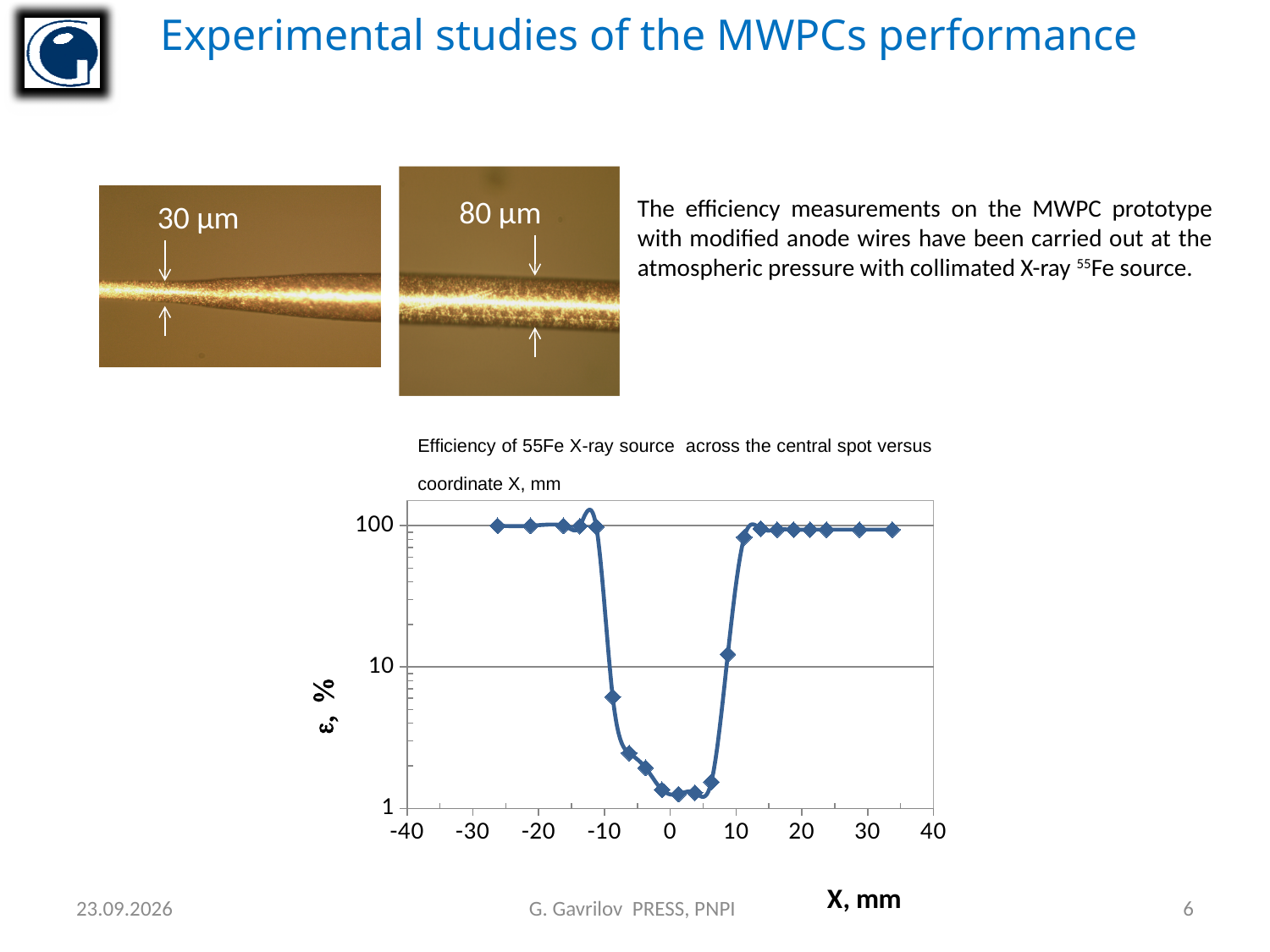
Is the efficiency at X = 0 mm greater or less than 10%? less Between X = -10 mm and X = 0 mm, do the efficiency values rise or fall? fall Which is larger, the efficiency at X = -20 mm or the efficiency at X = 0 mm? X = -20 mm Between X = 0 mm and X = 10 mm, do the efficiency values rise or fall? rise Is the efficiency at X = 30 mm greater or less than 10%? greater What is the label of the x axis of the chart? X, mm Is the efficiency at X = 20 mm greater or less than 10%? greater Which is larger, the efficiency at X = 5 mm or the efficiency at X = 25 mm? X = 25 mm What is the title of the chart? Efficiency of 55Fe X-ray source across the central spot versus coordinate X, mm What kind of chart is shown on the slide? line chart